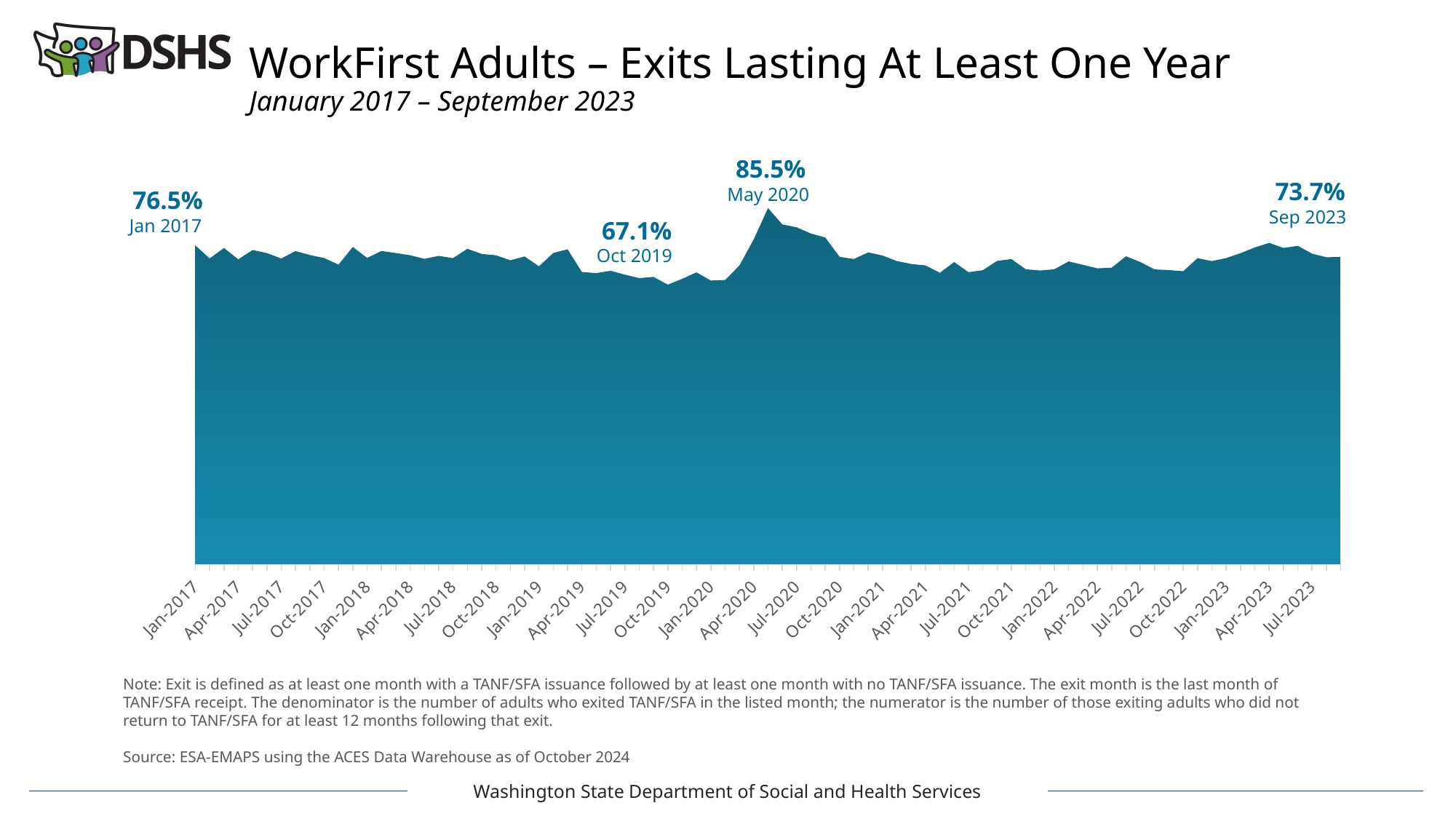
What is the value for Jan 2017? 76.5% Does the value rise or fall from Oct 2019 to May 2020? Rise Which labeled month has the lowest value? Oct 2019 Which labeled month has the highest value? May 2020 What is the difference between the May 2020 value and the Oct 2019 value? 18.4% What kind of chart is shown on the slide? Area chart What is the value for Sep 2023? 73.7% What is the title of the chart? WorkFirst Adults – Exits Lasting At Least One Year What is the value for May 2020? 85.5% Which is larger, the value for Jan 2017 or the value for Sep 2023? Jan 2017 What is the value for Oct 2019? 67.1% What is the difference between the Jan 2017 value and the Sep 2023 value? 2.8%